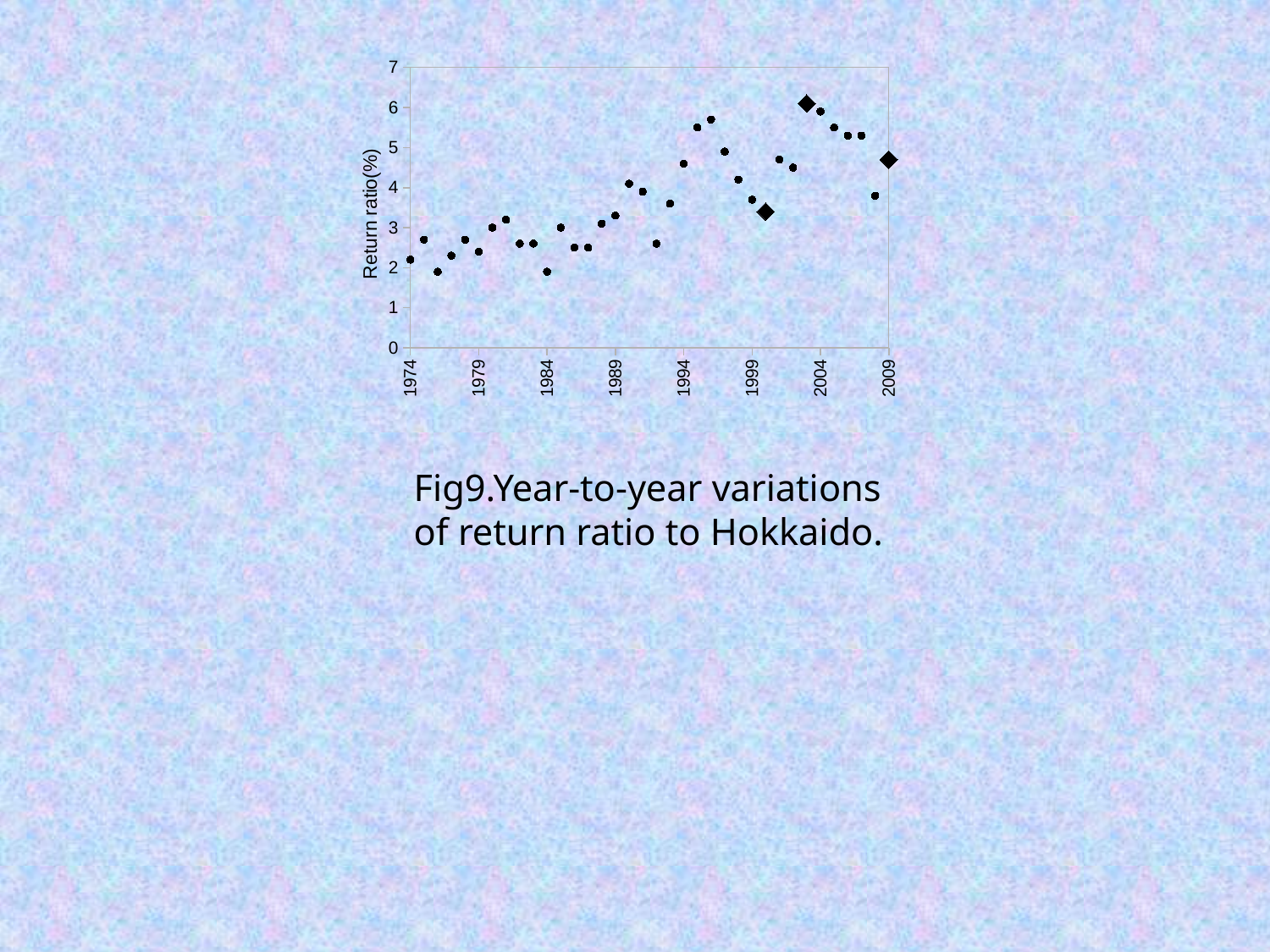
Is the return ratio for 1996 greater or less than 5? greater Is the return ratio for 1974 greater or less than 3? less Which year has the larger return ratio, 1984 or 1996? 1996 Is the return ratio for 2009 greater or less than 4? greater Which year has the larger return ratio, 1974 or 2009? 2009 Overall, does the return ratio rise or fall from 1974 to 2009? rise What is the label of the vertical axis of the chart? Return ratio(%) What is the caption given for the chart on the slide? Fig9.Year-to-year variations of return ratio to Hokkaido. What kind of chart is shown on the slide? scatter chart